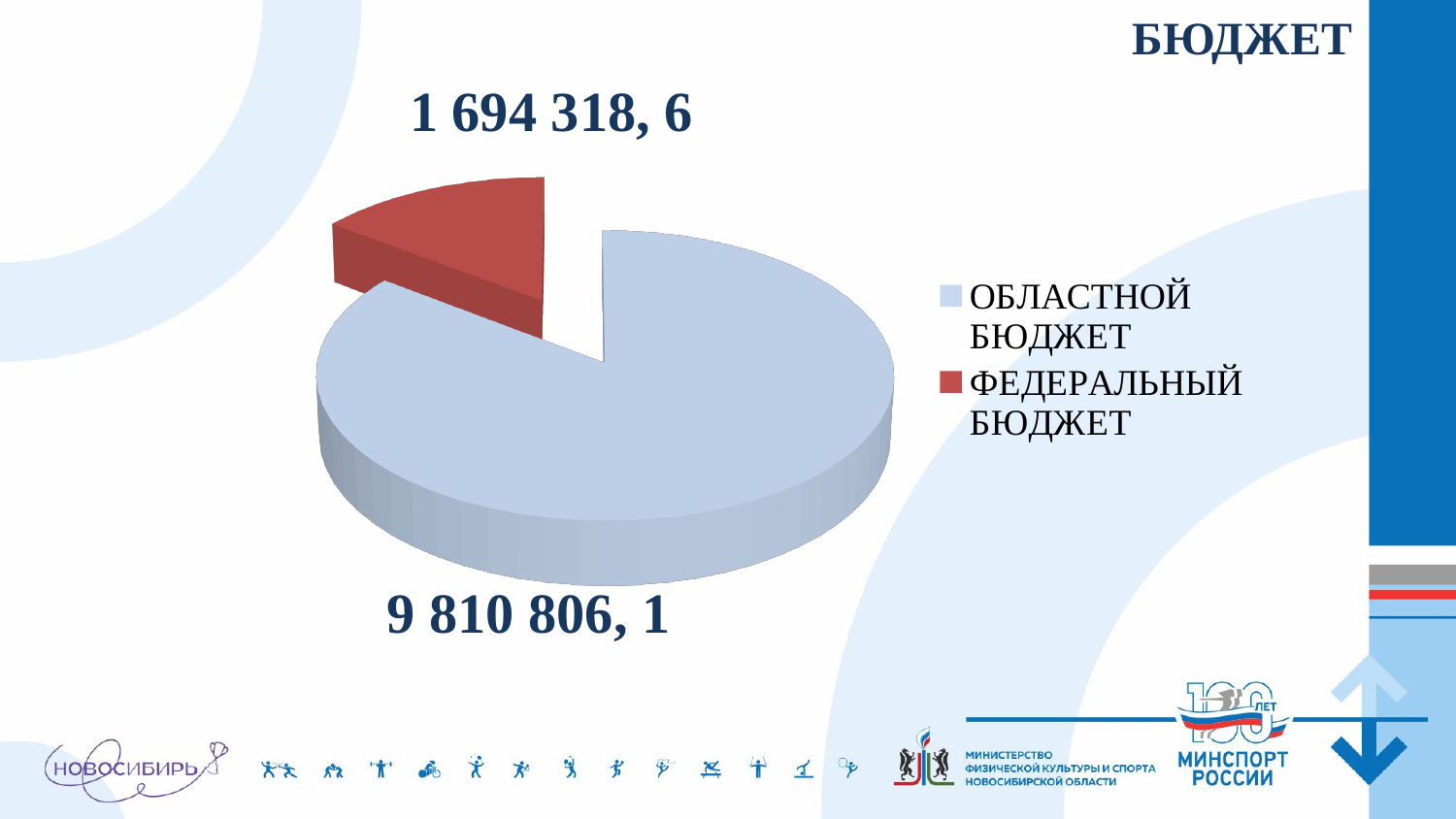
Which slice of the pie is the smallest? ФЕДЕРАЛЬНЫЙ БЮДЖЕТ What colour is the ФЕДЕРАЛЬНЫЙ БЮДЖЕТ slice? Red Which slice of the pie is the largest? ОБЛАСТНОЙ БЮДЖЕТ How many slices does the pie chart have? 2 What kind of chart is shown on the slide? Pie chart What value is shown for ОБЛАСТНОЙ БЮДЖЕТ? 9 810 806, 1 What is the total of the two values shown on the pie chart? 11 505 124, 7 What is the difference between the ОБЛАСТНОЙ БЮДЖЕТ value and the ФЕДЕРАЛЬНЫЙ БЮДЖЕТ value? 8 116 487, 5 Which is larger, ОБЛАСТНОЙ БЮДЖЕТ or ФЕДЕРАЛЬНЫЙ БЮДЖЕТ? ОБЛАСТНОЙ БЮДЖЕТ What is the title of the slide? БЮДЖЕТ What value is shown for ФЕДЕРАЛЬНЫЙ БЮДЖЕТ? 1 694 318, 6 How many entries does the legend list? 2